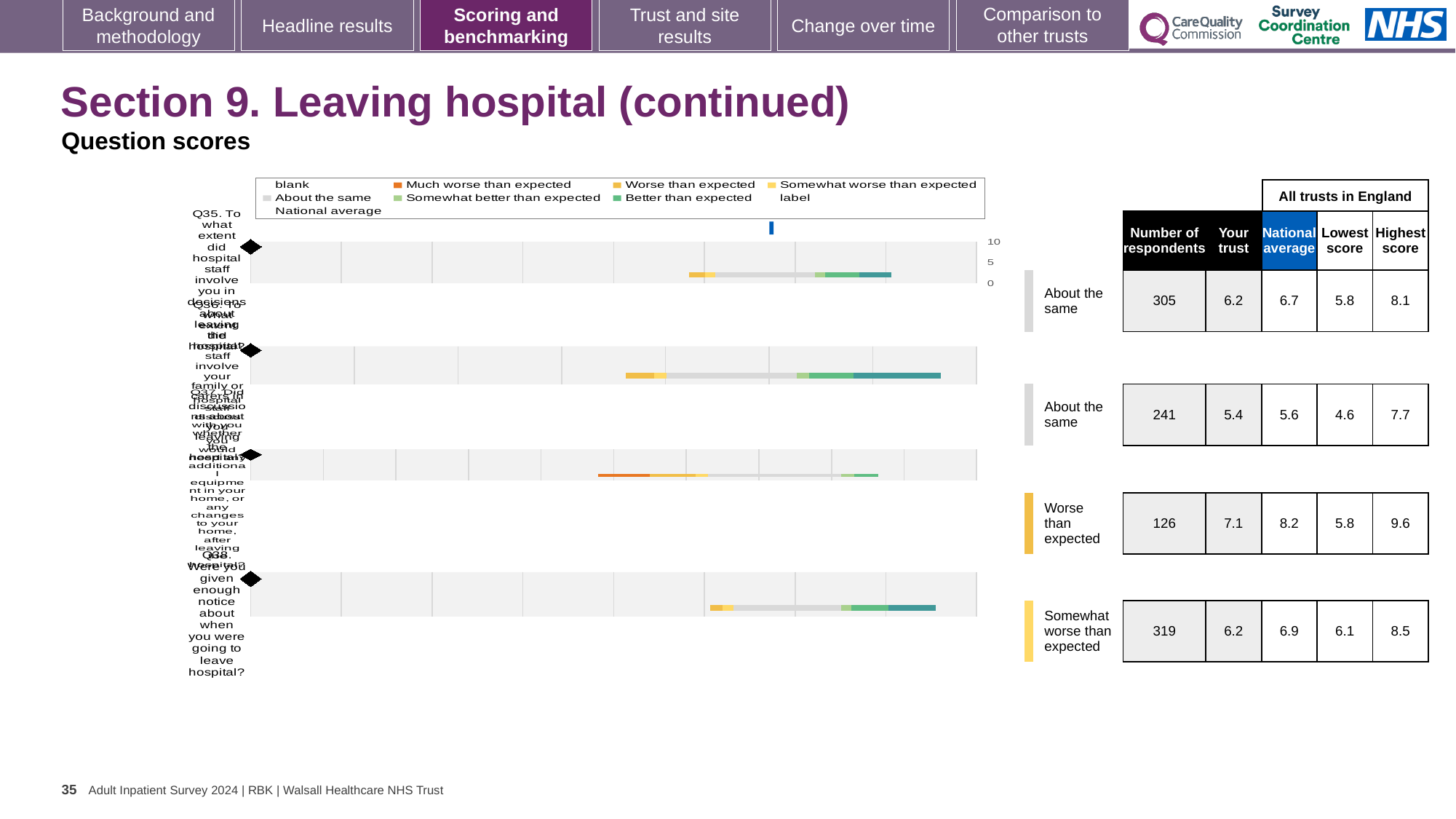
For the first row (Q35), is the 'Your trust' score or the national average larger? national average In the table beside the chart, what is the number of respondents for the third row? 126 Which row in the table has the highest number of respondents? the last row (Q38), 319 What is the difference between the national average and the 'Your trust' score for the third row? 1.1 How many entries does the chart legend list? 9 What kind of chart is shown on the slide? bar chart How many question rows (bars) are plotted in the chart? 4 In the table beside the chart, what is the 'Your trust' score for the first row (Q35)? 6.2 In the table beside the chart, what is the national average for the last row (Q38)? 6.9 Which row in the table has the lowest 'Your trust' score? the second row, 5.4 In the table beside the chart, what is the highest score in England for the second row? 7.7 What benchmark category is shown for the third row of the chart? Worse than expected